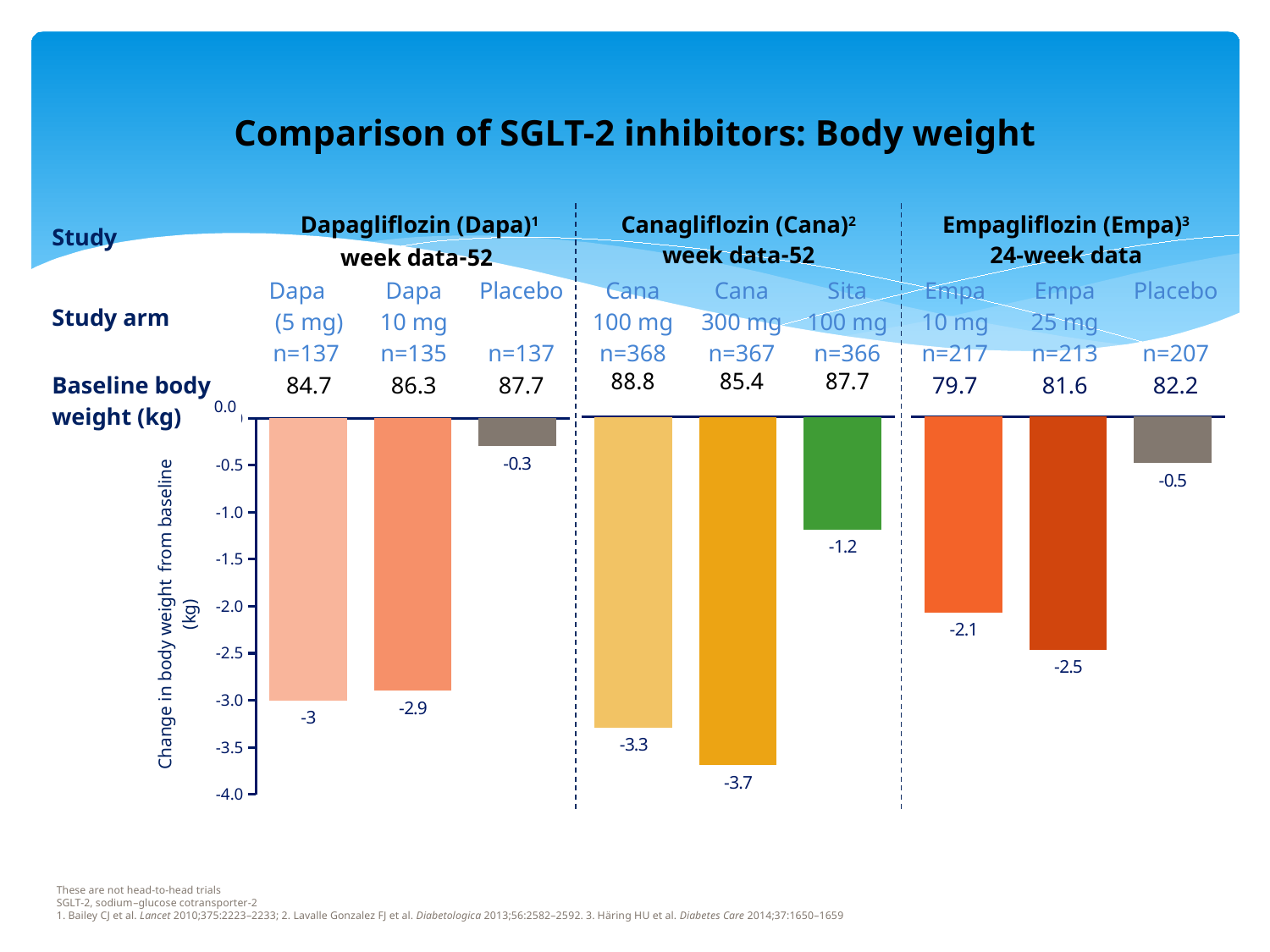
What is the difference between the body weight change for Empa 25 mg and Empa 10 mg? 0.4 What type of chart is used to show the change in body weight? Bar chart What is the difference between the body weight change for Cana 300 mg and Cana 100 mg? 0.4 Which shows a larger reduction in body weight: Dapa 10 mg or Empa 25 mg? Dapa 10 mg Which study arm shows the smallest change in body weight from baseline? Placebo (Dapagliflozin study) What is the change in body weight from baseline for Cana 300 mg? -3.7 How many bars are plotted in the chart? 9 What is the change in body weight from baseline for Dapa (5 mg)? -3 What is the title of the slide? Comparison of SGLT-2 inhibitors: Body weight Which study arm shows the largest reduction in body weight from baseline? Cana 300 mg What is the change in body weight from baseline for Sita 100 mg? -1.2 What is the change in body weight from baseline for Empa 25 mg? -2.5